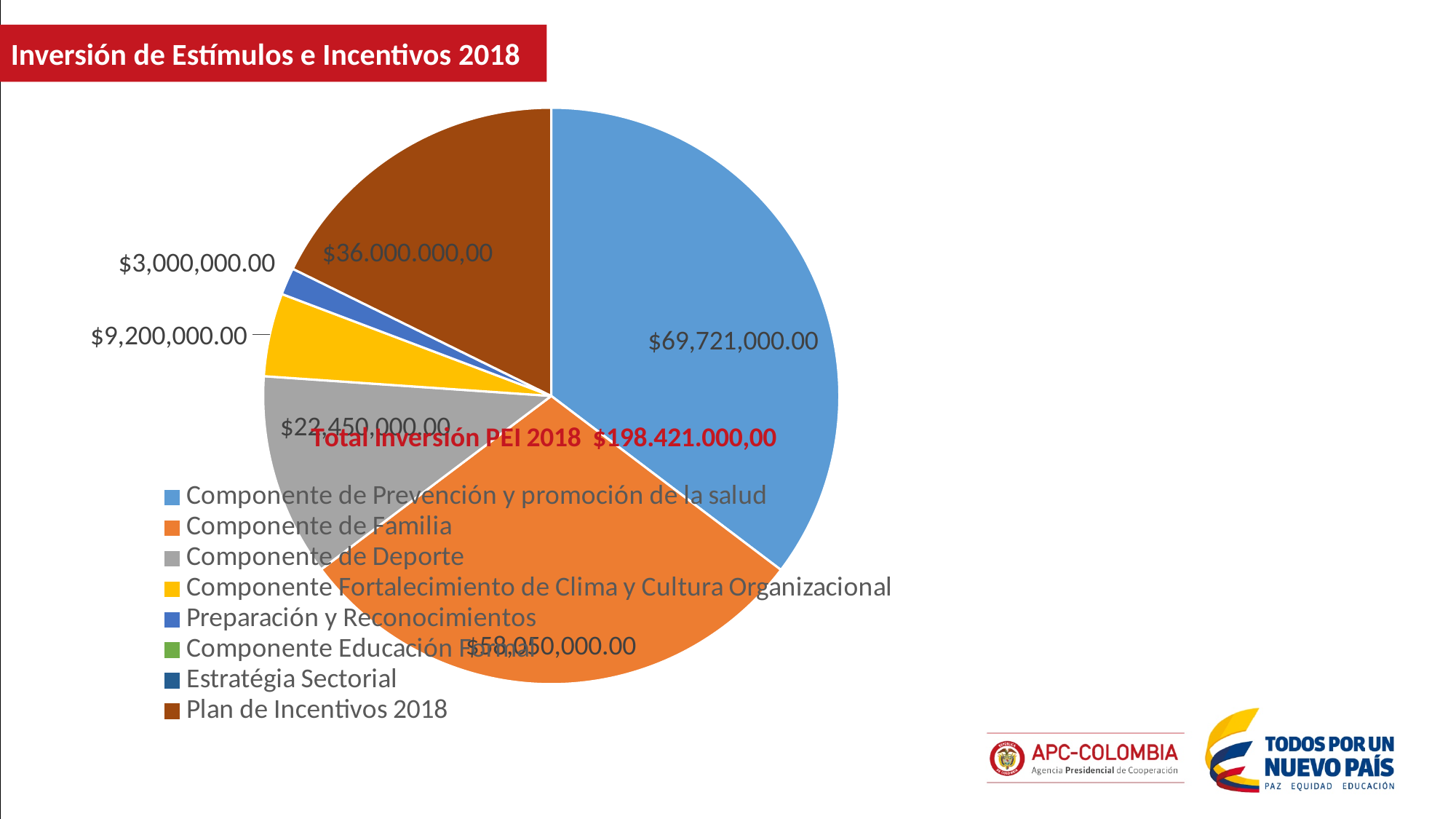
What total investment (Total Inversión PEI 2018) is printed on the chart? $198.421.000,00 What is the value for Componente Fortalecimiento de Clima y Cultura Organizacional? $9,200,000.00 How many entries does the legend list? 8 What kind of chart is shown on the slide? Pie chart Which is larger, the value for Componente de Deporte or the value for Componente Fortalecimiento de Clima y Cultura Organizacional? Componente de Deporte Which category has the largest slice of the pie? Componente de Prevención y promoción de la salud What is the value for Componente de Familia? $58,050,000.00 What is the value for Preparación y Reconocimientos? $3,000,000.00 What is the value for Plan de Incentivos 2018? $36.000.000,00 What is the difference between the values for Componente de Prevención y promoción de la salud and Componente de Familia? $11,671,000.00 What is the title of the chart? Inversión de Estímulos e Incentivos 2018 What is the value for Componente de Prevención y promoción de la salud? $69,721,000.00